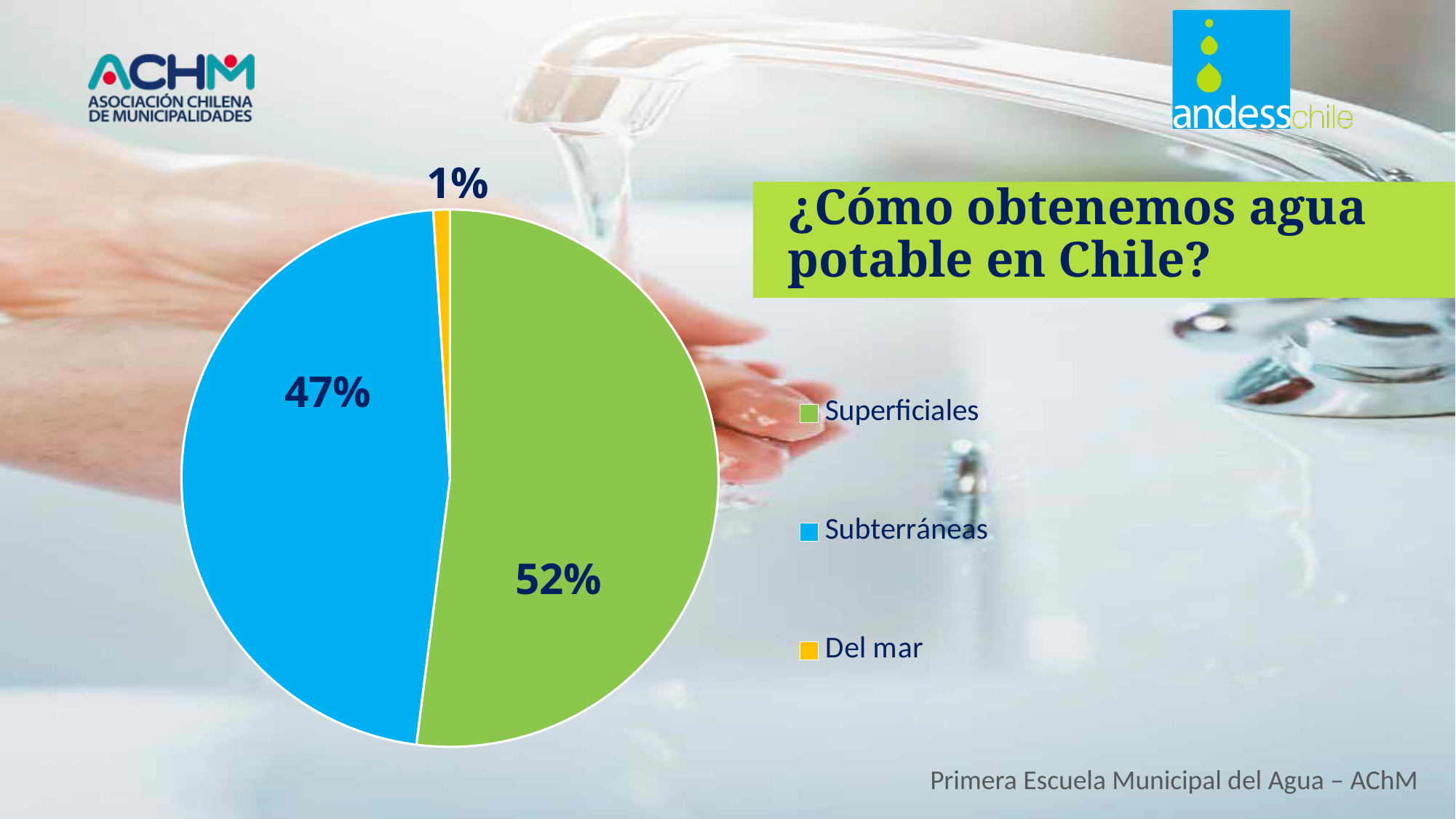
What share of the pie does Subterráneas represent? 47% What kind of chart is shown on the slide? pie chart What is the title shown next to the chart? ¿Cómo obtenemos agua potable en Chile? How many categories does the pie chart show? 3 Which category has the smallest slice of the pie? Del mar Which category has the largest slice of the pie? Superficiales What is the difference in percentage points between Superficiales and Subterráneas? 5 What colour is the slice for Subterráneas? blue What share of the pie does Del mar represent? 1% How many entries does the legend list? 3 Which is larger, the share for Subterráneas or the share for Del mar? Subterráneas What share of the pie does Superficiales represent? 52%